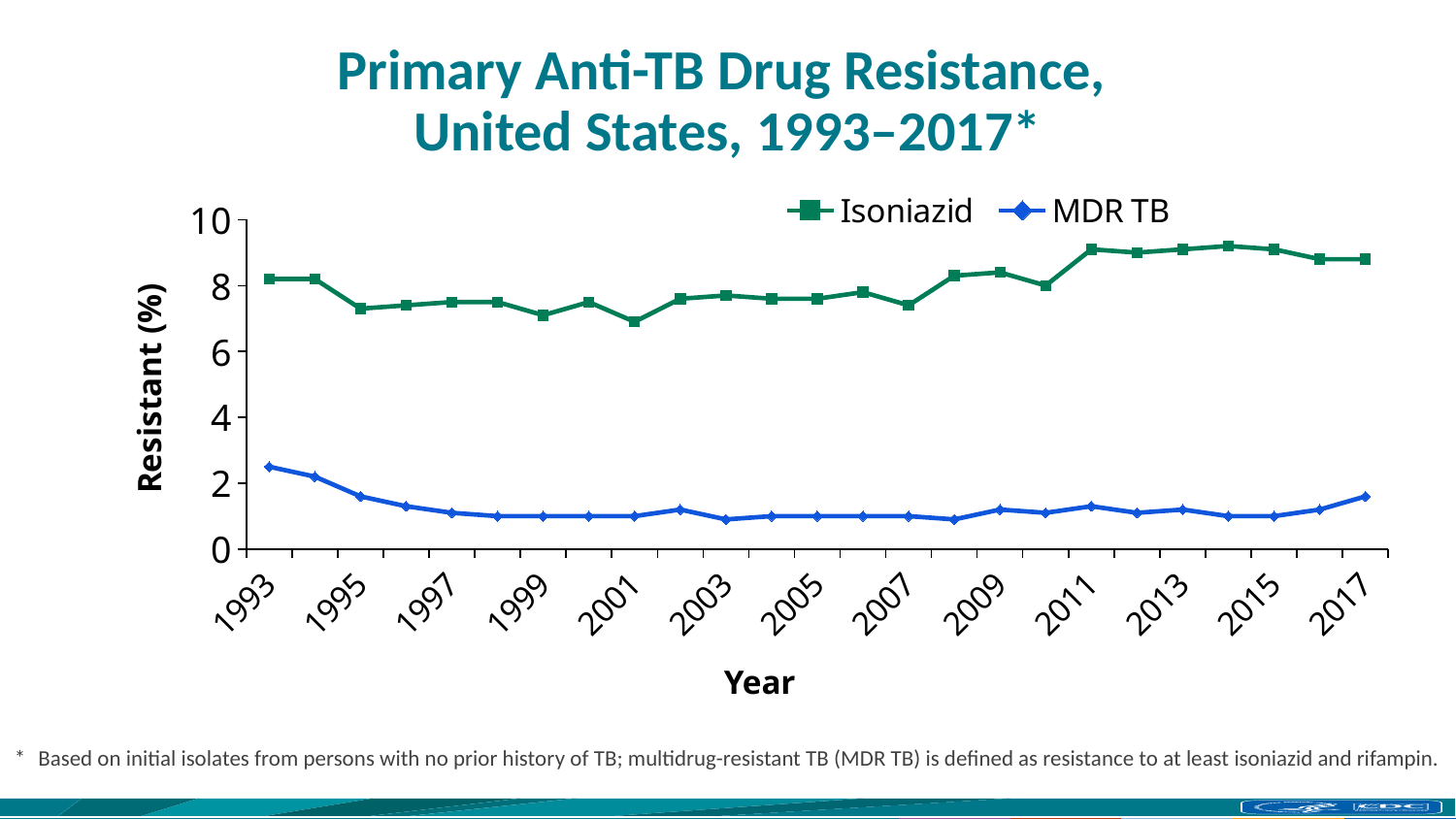
Which is larger, the Isoniazid value for 2011 or the Isoniazid value for 2001? 2011 Is the Isoniazid value for 2001 greater or less than 8? less Is the MDR TB value for 1993 greater or less than 2? greater Is the MDR TB value for 2005 greater or less than 2? less Does the MDR TB series rise or fall between 1993 and 1999? Fall What kind of chart is shown on the slide? Line chart How many year labels are shown on the x axis? 13 What is the title of the y axis? Resistant (%) In which year does the MDR TB series reach its highest value? 1993 How many series does the legend list? 2 Which series is plotted with the higher values throughout the chart, Isoniazid or MDR TB? Isoniazid